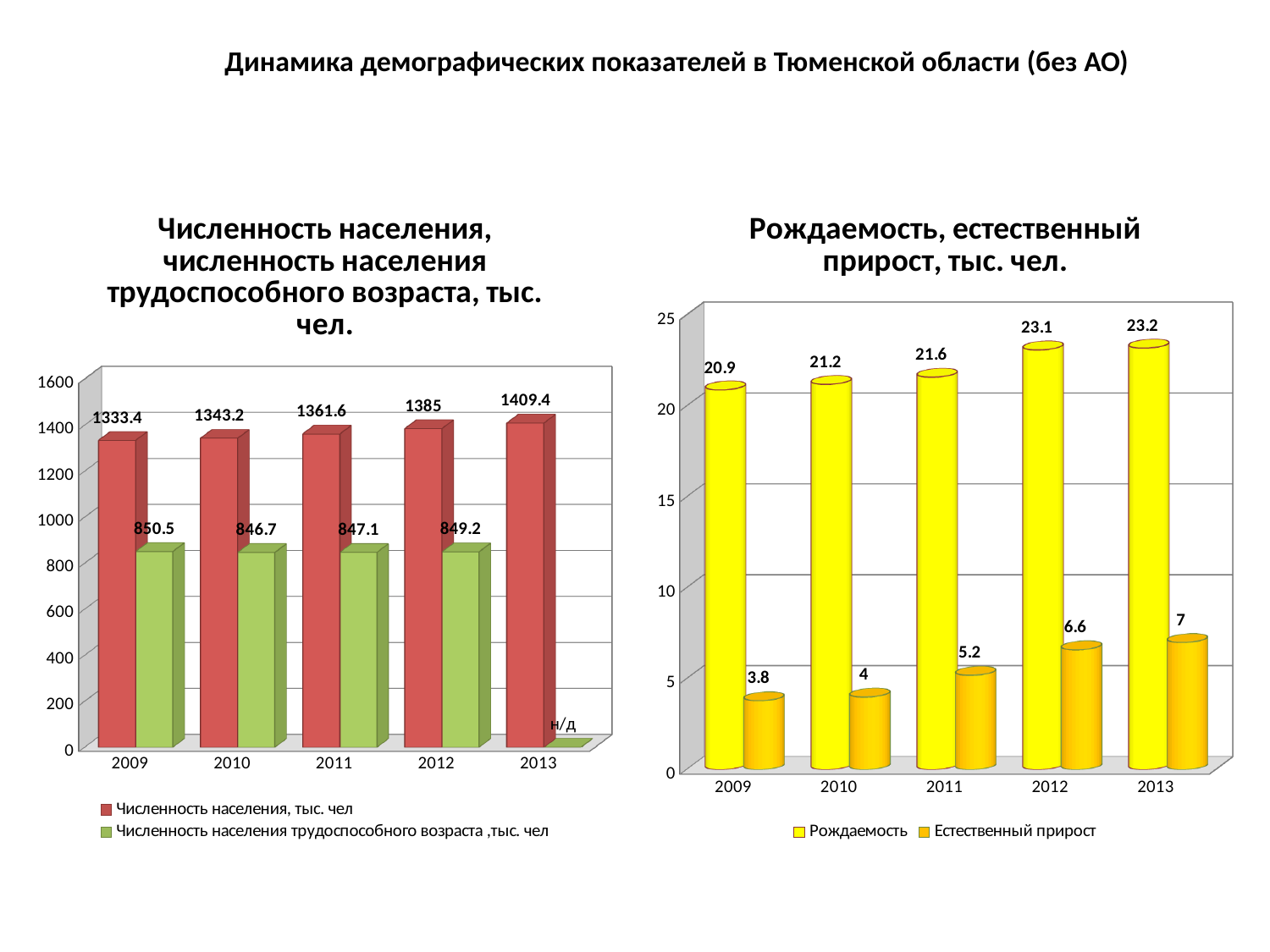
What kind of chart is the right chart? bar chart In the left chart, does Численность населения rise or fall from 2009 to 2013? rise In the right chart, what is the value of Естественный прирост for 2010? 4 In the right chart (Рождаемость, естественный прирост), what is the value of Рождаемость for 2012? 23.1 In the left chart, what is shown for Численность населения трудоспособного возраста in 2013? н/д In the right chart, which year has the lowest value for Естественный прирост? 2009 In the left chart (Численность населения...), what is the value of Численность населения, тыс. чел for 2011? 1361.6 In the right chart, what is the difference between Рождаемость and Естественный прирост in 2013? 16.2 How many series does the legend of the right chart list? 2 In the left chart, what is the value of Численность населения трудоспособного возраста for 2009? 850.5 In the left chart, what is the difference between Численность населения in 2013 and in 2009? 76 In the left chart, which year has the highest value for Численность населения, тыс. чел? 2013